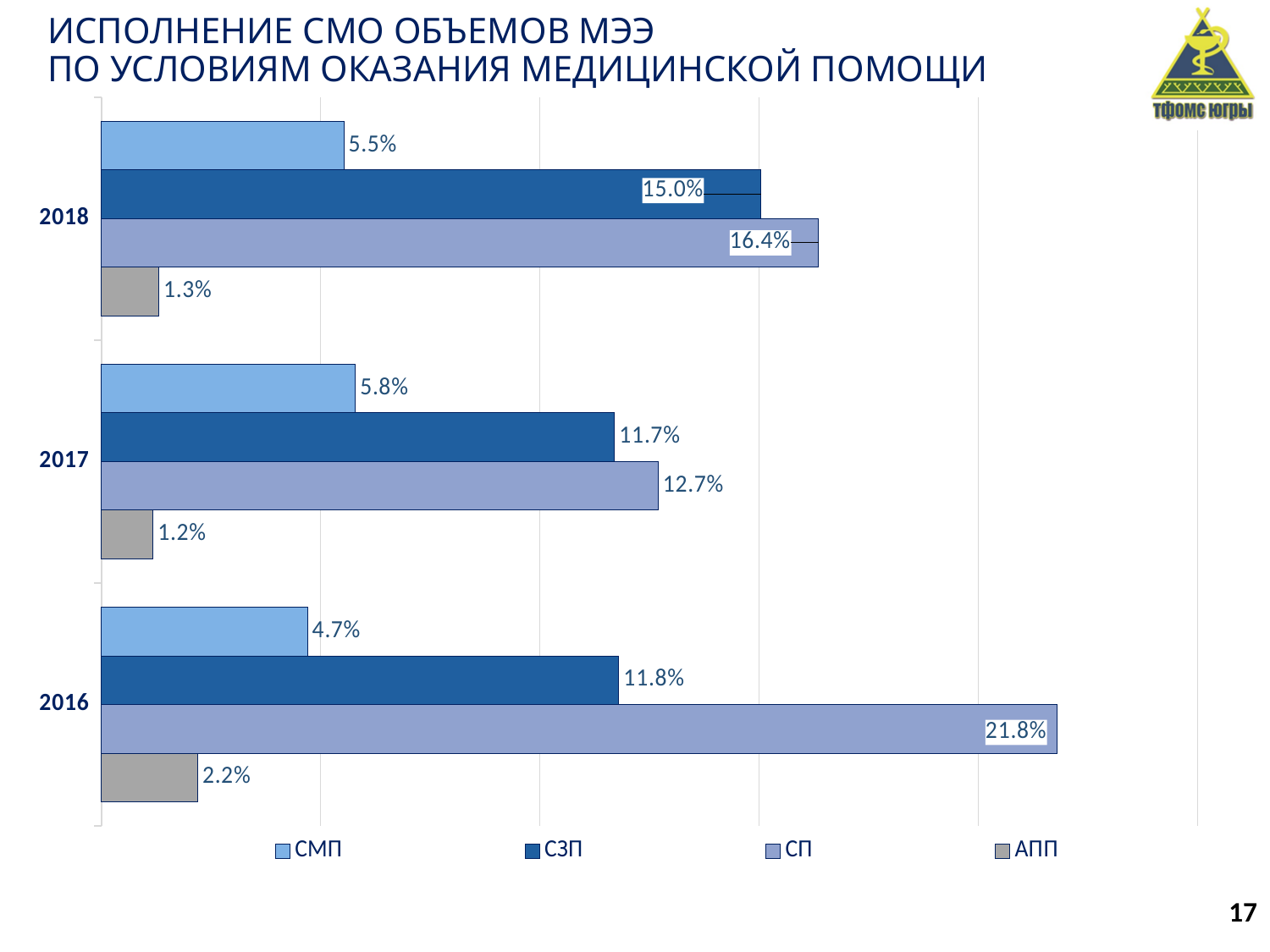
What is the value for СП in 2016? 21.8% Which series is shown in grey in the legend? АПП How many series does the legend list? 4 What is the difference between the СП and СЗП values in 2018? 1.4% Which series has the lowest value in 2016? АПП Which series has the highest value in 2018? СП What is the value for АПП in 2017? 1.2% What is the value for СМП in 2017? 5.8% How many years (categories) are shown on the chart? 3 Which is larger: the СМП value in 2017 or the СМП value in 2016? СМП in 2017 What kind of chart is shown on the slide? Bar chart What is the value for СЗП in 2018? 15.0%